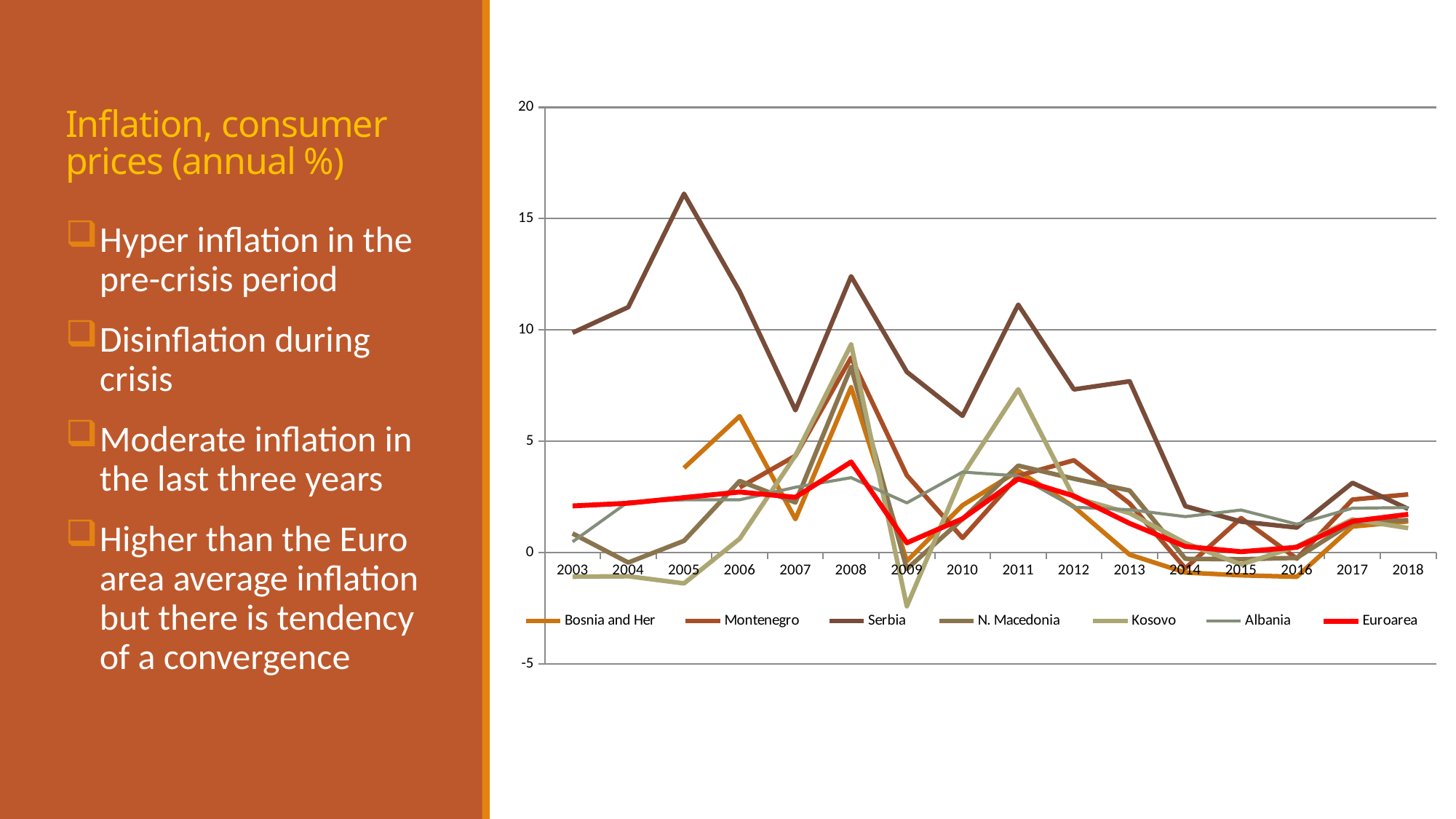
Which series has the highest value in 2013? Serbia Is the value for Serbia in 2008 greater or less than 10? greater What kind of chart is shown on the slide? line chart Is the value for Kosovo in 2009 greater or less than 0? less What colour is the Euroarea line? red How many years are shown along the x axis? 16 How many series does the legend list? 7 Does the Serbia line rise or fall from 2013 to 2016? fall Is the value for Serbia in 2005 greater or less than 15? greater Which series has the highest value in 2005? Serbia